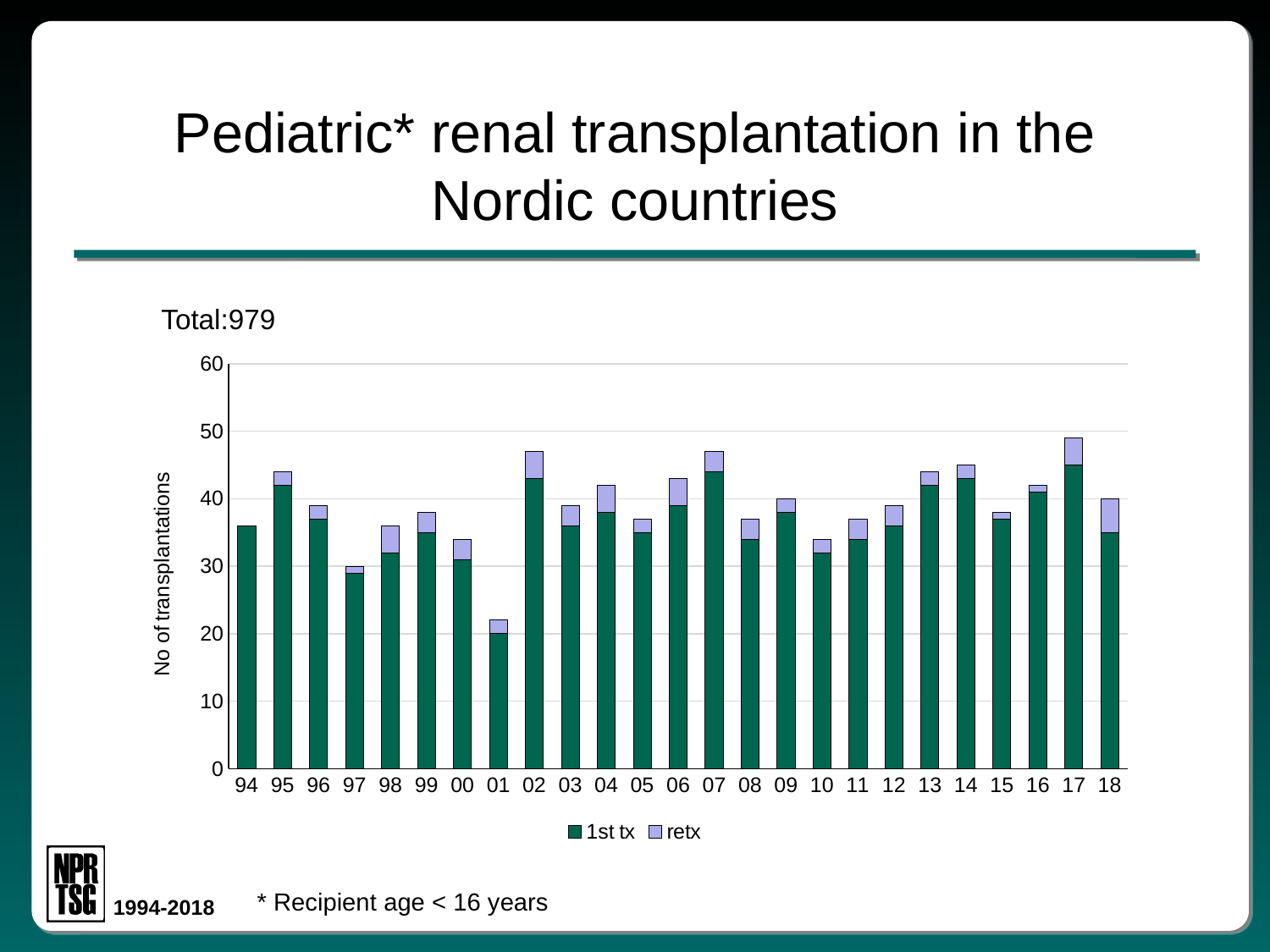
Is the total number of transplantations in 17 greater or less than 40? greater What are the two series named in the legend? 1st tx and retx What is the total number of transplantations stated above the chart? 979 How many years are shown along the x axis? 25 Do the total transplantations rise or fall from 01 to 02? rise How many series does the legend list? 2 What kind of chart is shown on the slide? bar chart Which year has the highest total number of transplantations? 17 Which year has the larger total number of transplantations, 07 or 10? 07 Is the total number of transplantations in 01 greater or less than 30? less Which year has the lowest total number of transplantations? 01 Is the total number of transplantations in 97 greater or less than 40? less